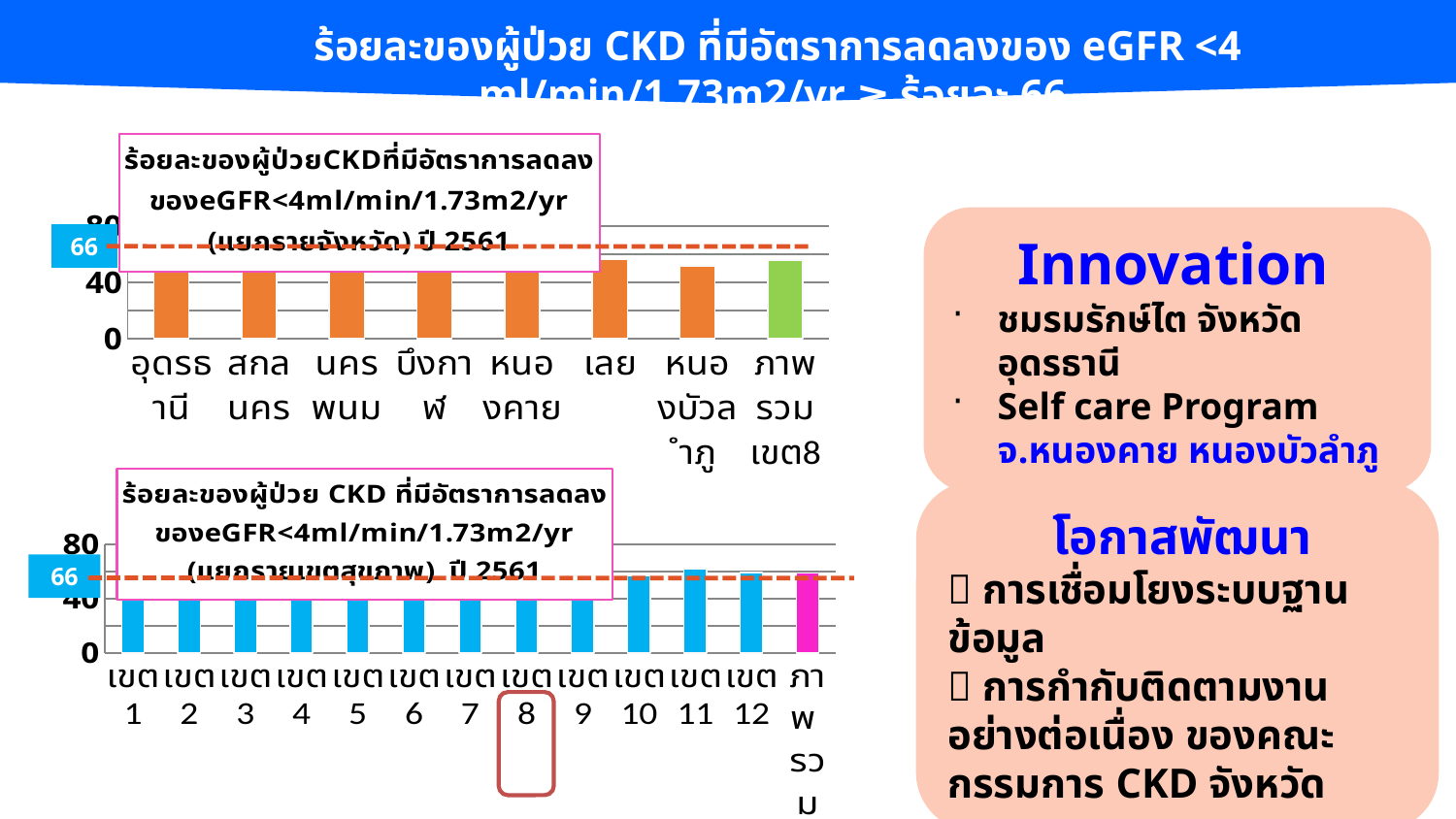
What value does the dashed horizontal reference line mark on both charts? 66 What kind of chart is the top chart (by province)? bar chart In the bottom chart (by health region), is the value for เขต 11 greater or less than 80? less What kind of chart is the bottom chart (by health region)? bar chart In the bottom chart (by health region), is the value for เขต 1 greater or less than 40? greater How many categories are shown on the x axis of the bottom chart (by health region)? 13 In the top chart (by province), is the value for ภาพรวมเขต8 greater or less than 80? less How many categories are shown on the x axis of the top chart (by province)? 8 In the top chart (by province), which bar is coloured green instead of orange? ภาพรวมเขต8